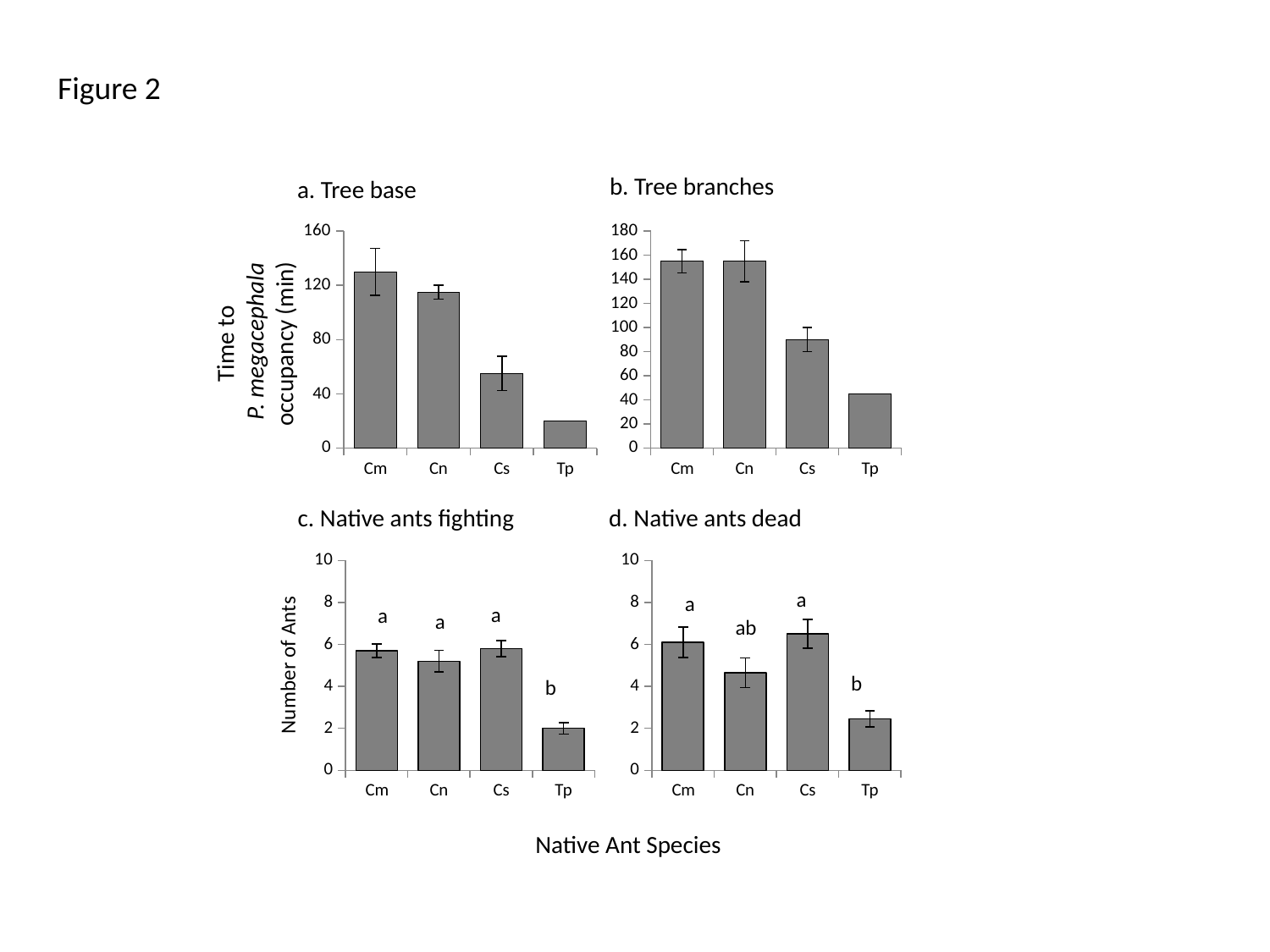
In the 'c. Native ants fighting' chart, is the value for Cm greater or less than 4? greater In the 'a. Tree base' chart, is the value for Cs greater or less than 80? less In the 'a. Tree base' chart, is the value for Cm greater or less than 120? greater In the 'b. Tree branches' chart, which native ant species has the lowest time to P. megacephala occupancy? Tp What kind of chart is the 'c. Native ants fighting' chart? bar chart In the 'c. Native ants fighting' chart, which native ant species has the lowest number of ants? Tp In the 'b. Tree branches' chart, which is larger, the value for Cs or the value for Tp? Cs In the 'a. Tree base' chart, which native ant species has the lowest time to P. megacephala occupancy? Tp In the 'a. Tree base' chart, which native ant species has the highest time to P. megacephala occupancy? Cm How many native ant species are shown on the x axis of the 'd. Native ants dead' chart? 4 In the 'd. Native ants dead' chart, which is larger, the value for Cn or the value for Cs? Cs